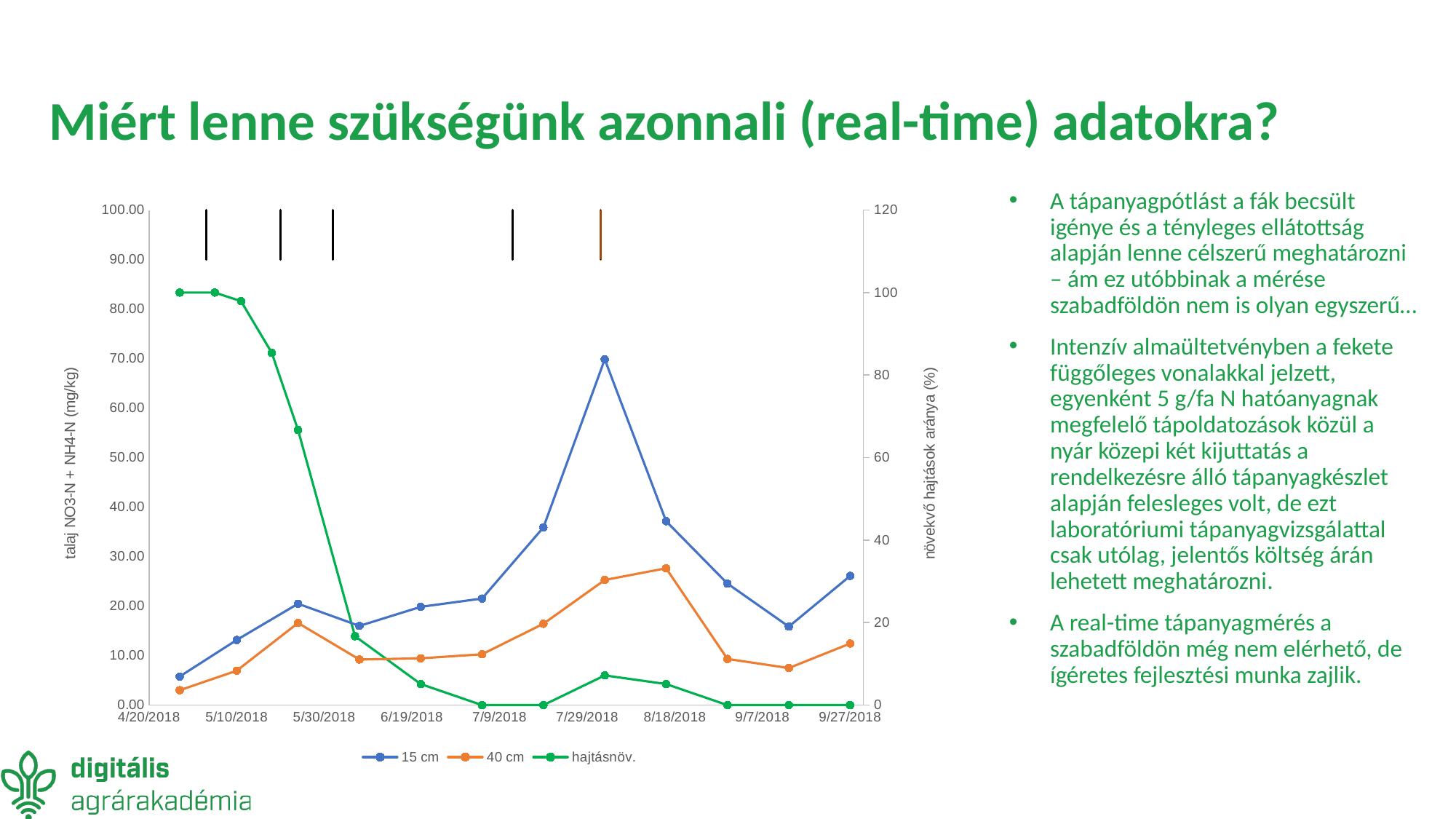
Which series reaches the highest value on the left axis, 15 cm or 40 cm? 15 cm Does the hajtásnöv. series generally rise or fall from late April to early July 2018? fall How many data points does the 15 cm series have? 12 What kind of chart is shown on the slide? line chart Is the peak value of the 15 cm series greater or less than 60.00? greater What is the title of the left vertical axis of the chart? talaj NO3-N + NH4-N (mg/kg) Which series is plotted in orange? 40 cm How many series does the chart legend list? 3 Is the peak value of the 40 cm series greater or less than 30.00? less Is the value of the 15 cm series at 9/27/2018 greater or less than 20.00? greater What are the three series named in the chart legend? 15 cm, 40 cm, hajtásnöv.